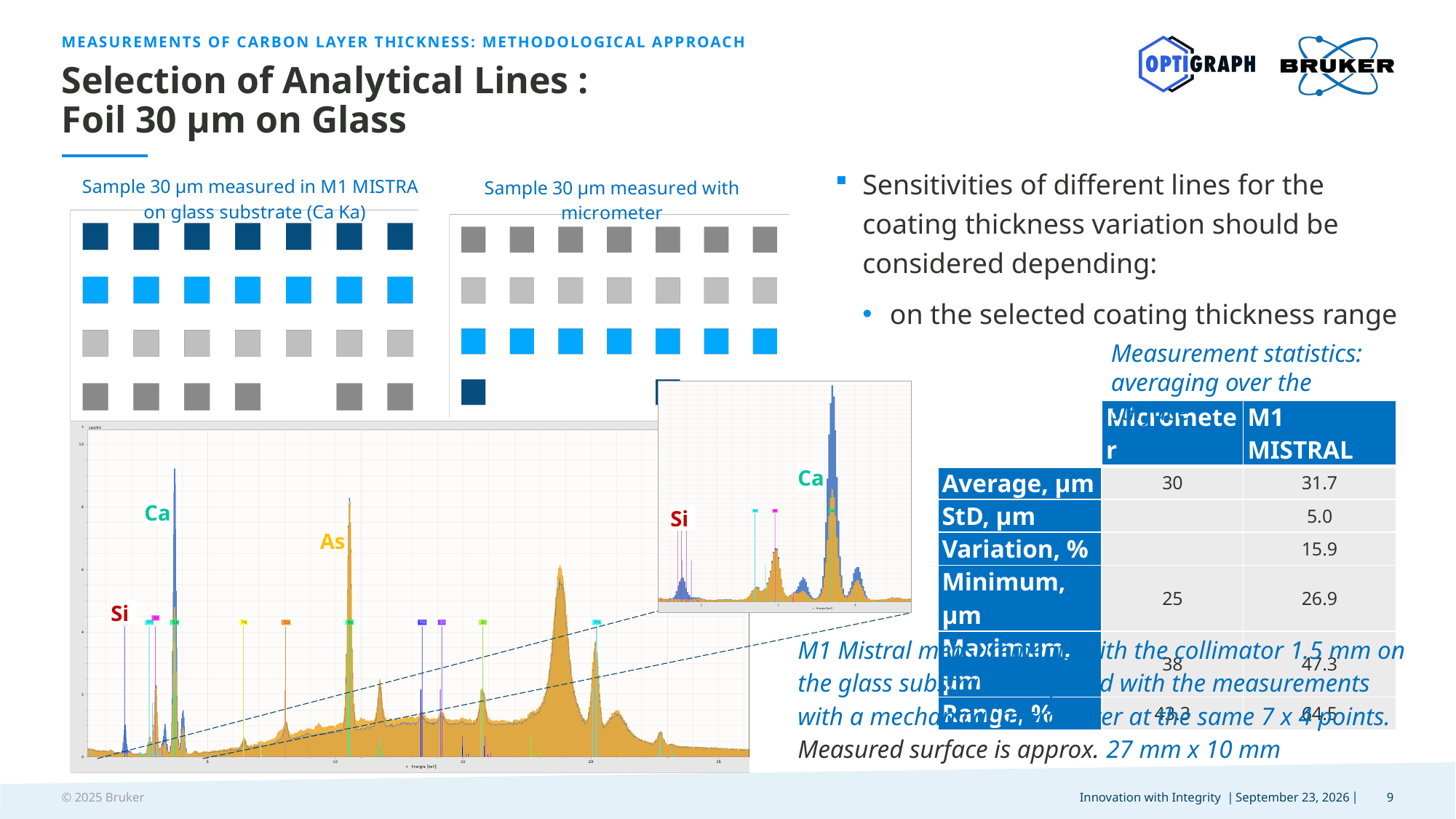
In the large spectrum chart at the bottom left, which labeled peak is the highest? Ca Which two element labels are printed on the small inset spectrum chart? Si and Ca In the small inset spectrum chart, which labeled peak is taller, Ca or Si? Ca What is the title of the left grid chart? Sample 30 µm measured in M1 MISTRA on glass substrate (Ca Ka) How many columns of squares does the left grid chart (M1 MISTRA on glass substrate) have? 7 In the large spectrum chart at the bottom left, which labeled peak is the lowest? Si What colour are the squares in the top row of the left grid chart? dark blue How many rows of squares does the right grid chart (measured with micrometer) have? 4 In the large spectrum chart at the bottom left, which labeled peak is taller, As or Si? As What kind of chart is the large chart at the bottom left of the slide? area chart In the large spectrum chart at the bottom left, which labeled peak is taller, Ca or As? Ca